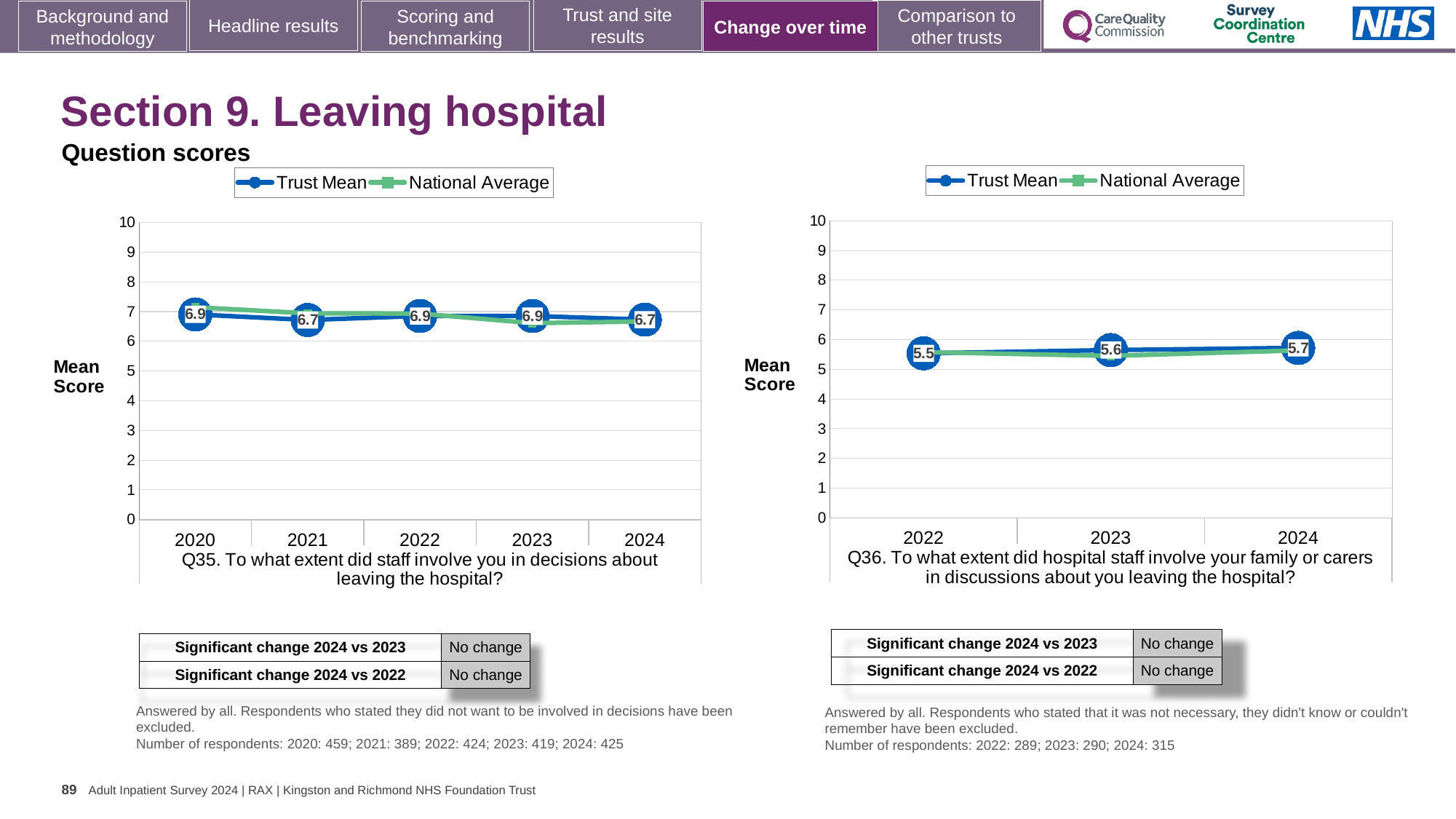
How many series does the legend of the Q36 chart (right) list? 2 On the Q36 chart (right), what is the Trust Mean score for 2022? 5.5 On the Q36 chart (right), which year has the highest Trust Mean score? 2024 On the Q35 chart (left), what is the difference between the Trust Mean scores for 2022 and 2024? 0.2 On the Q36 chart (right), which year has the lowest Trust Mean score? 2022 On the Q35 chart (left), what is the Trust Mean score for 2021? 6.7 On the Q36 chart (right), what is the difference between the Trust Mean scores for 2024 and 2022? 0.2 How many years are plotted on the Q35 chart (left)? 5 What kind of chart is the Q36 chart (right)? Line chart On the Q35 chart (left), what is the Trust Mean score for 2024? 6.7 On the Q35 chart (left), is the Trust Mean score for 2020 greater or less than 6? greater On the Q36 chart (right), what is the Trust Mean score for 2024? 5.7